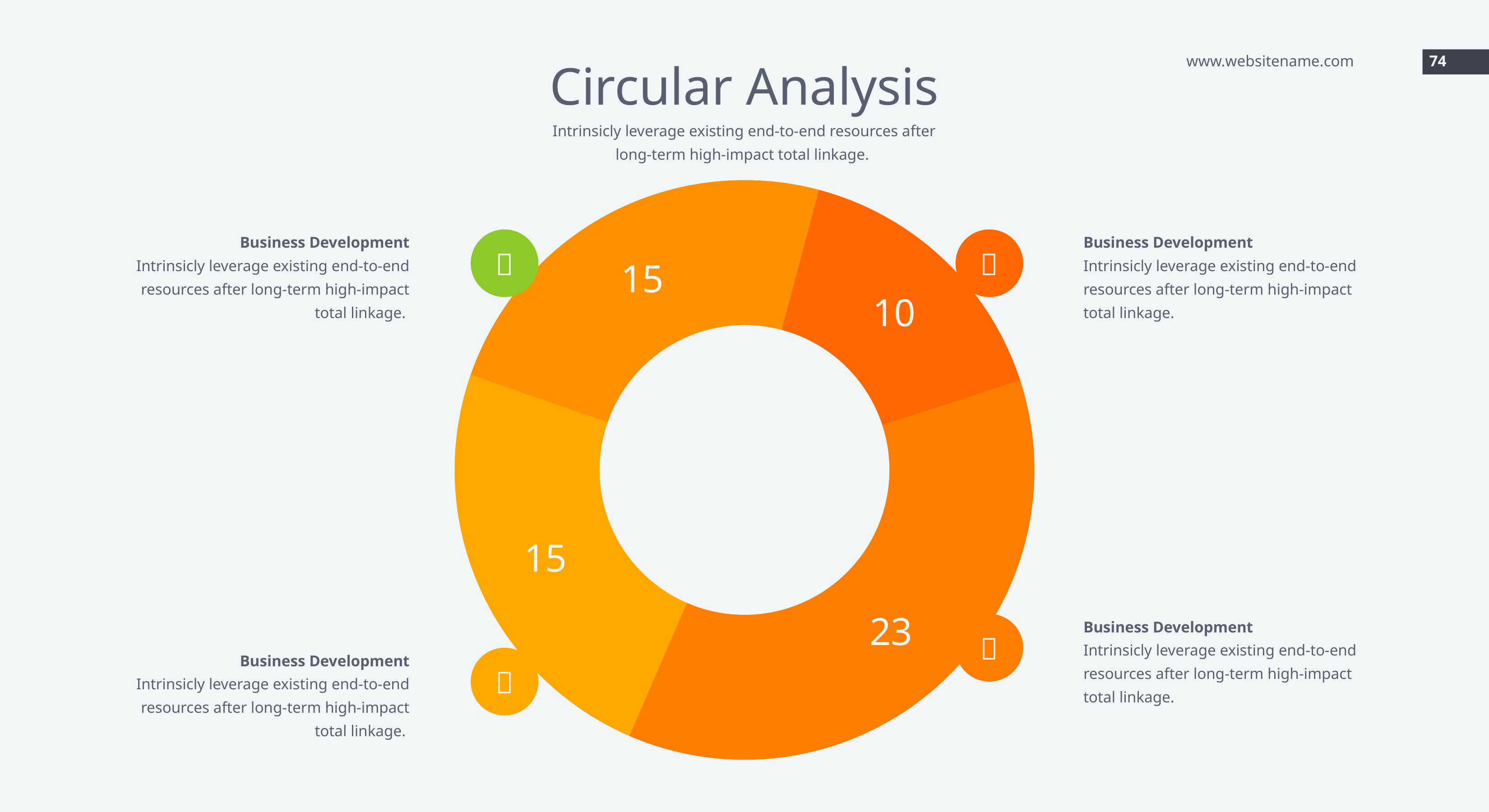
What is the value of the segment at the bottom right of the donut chart? 23 Which is larger: the bottom-right segment or the top-right segment? bottom-right segment (23) What is the difference between the largest segment (23) and the smallest segment (10)? 13 How many segments does the donut chart have? 4 What is the total of all four segment values in the donut chart? 63 What is the value of the largest segment in the donut chart? 23 What is the title of the chart on the slide? Circular Analysis What is the value of the yellow segment on the left side of the donut chart? 15 What is the value of the dark orange segment at the top right of the donut chart? 10 What is the value of the smallest segment in the donut chart? 10 What kind of chart is shown on the slide? donut chart How many segments in the donut chart are labelled 15? 2